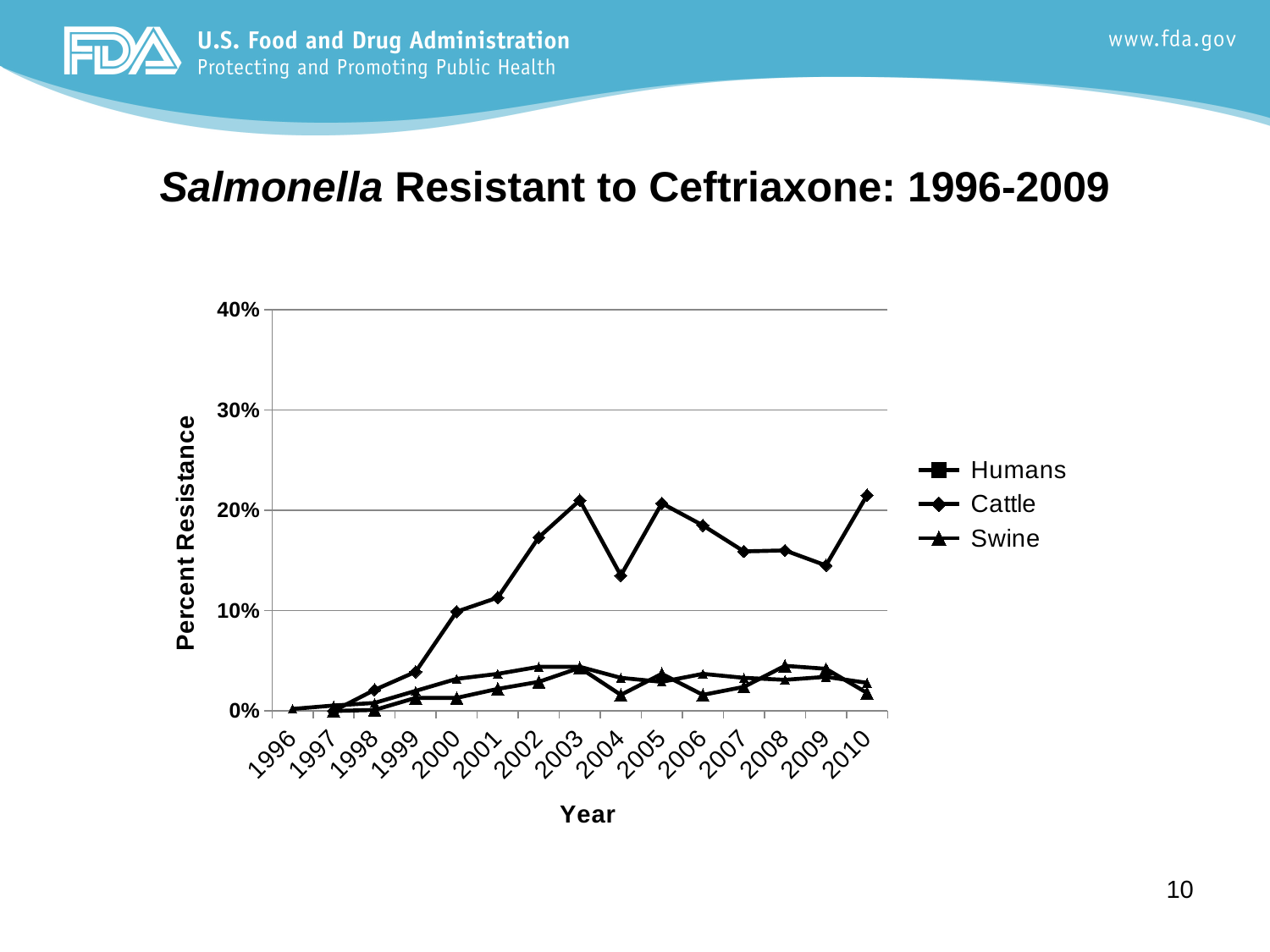
How many series does the legend list? 3 Is the value for Swine in 2008 greater or less than 10%? less What kind of chart is shown on the slide? line chart Which is larger in 2005, the value for Cattle or the value for Swine? Cattle Which series has the highest percent resistance in 2010? Cattle Does the Cattle series rise or fall between 1996 and 2003? rise What is the label of the y axis? Percent Resistance Which series has the highest percent resistance in 2003? Cattle Is the value for Cattle in 2004 greater or less than 10%? greater Is the value for Cattle in 1999 greater or less than 10%? less How many years are plotted along the x axis? 15